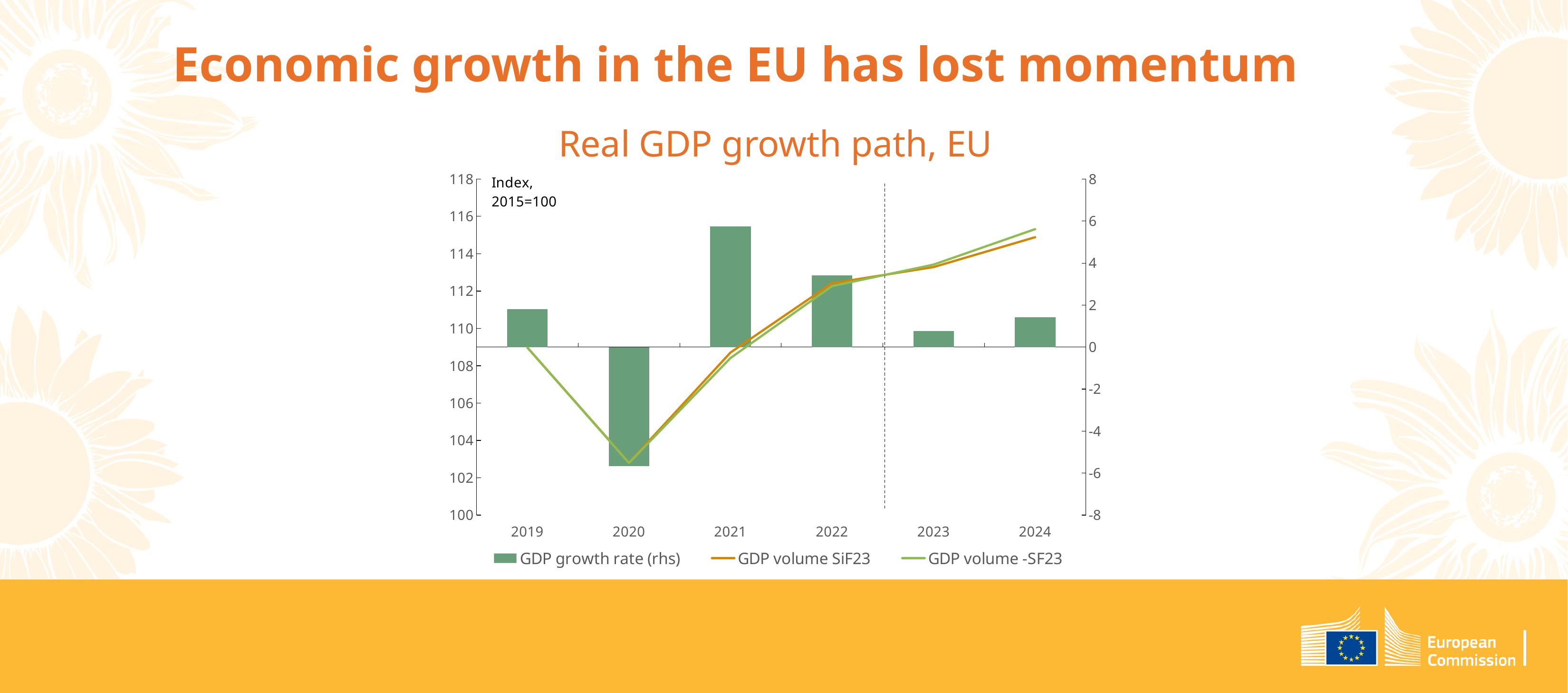
Do the GDP volume lines rise or fall from 2021 to 2024? rise Is the GDP growth rate for 2021 greater or less than 4 on the right-hand axis? greater In which year is the GDP growth rate bar the highest? 2021 Is the GDP volume SiF23 value for 2020 greater or less than 104 on the left-hand axis? less Is the GDP growth rate for 2023 greater or less than 2 on the right-hand axis? less In which year is the GDP growth rate bar the lowest? 2020 How many series does the chart's legend list? 3 Which year has a larger GDP growth rate bar, 2019 or 2023? 2019 What is the title of the chart? Real GDP growth path, EU What kind of chart is shown on the slide? A combined bar and line chart How many years are shown on the x axis of the chart? 6